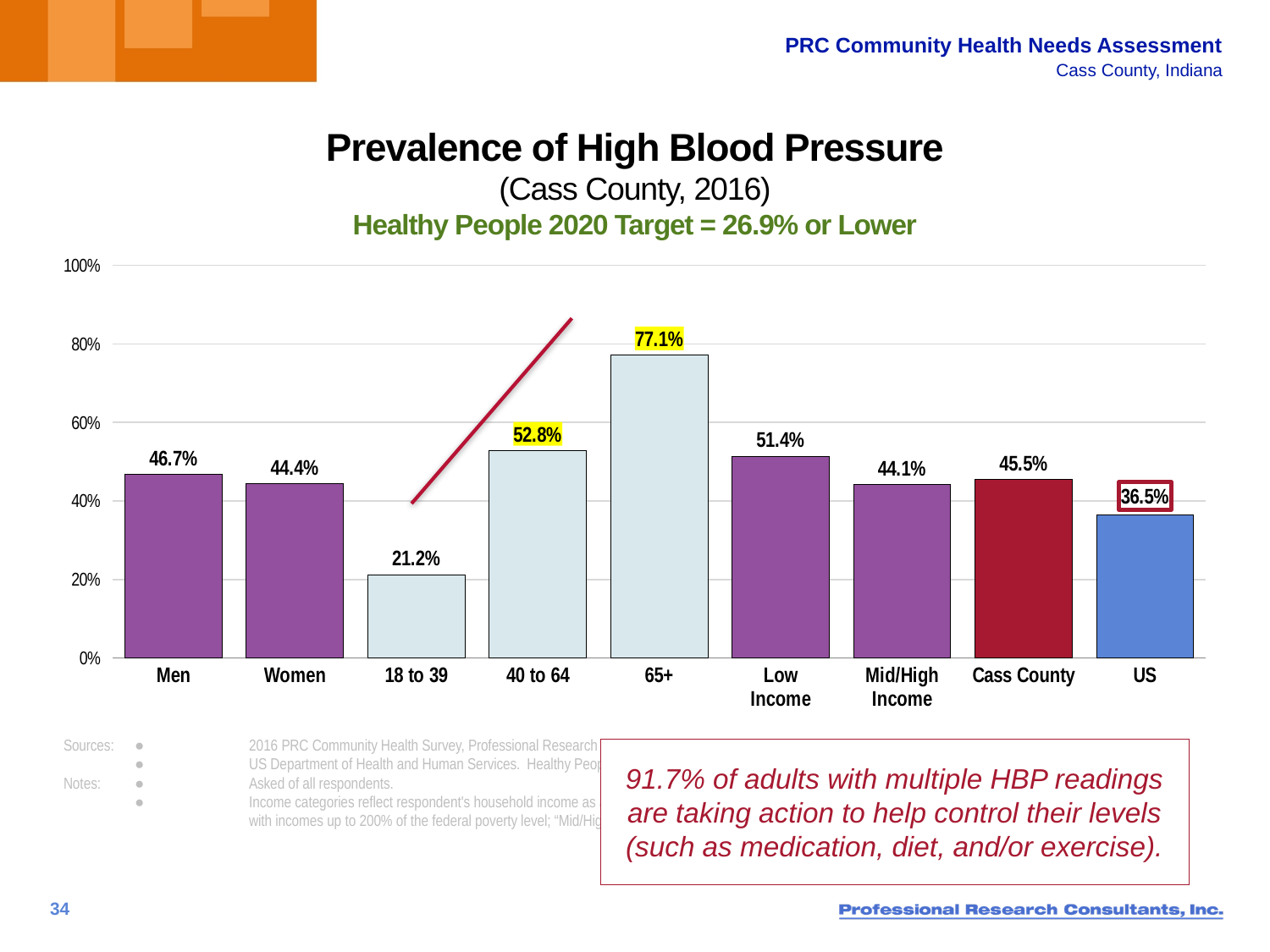
How many categories are shown on the x axis? 9 Which category has the highest prevalence of high blood pressure? 65+ What is the difference between the 65+ value and the 18 to 39 value? 55.9% What is the prevalence of high blood pressure for Men? 46.7% What is the value shown for the US? 36.5% What is the value shown for Low Income? 51.4% What is the difference between the Cass County value and the US value? 9.0% What is the value shown for the 65+ age group? 77.1% What is the Healthy People 2020 Target stated in the chart subtitle? 26.9% or Lower Which is larger, the value for Low Income or the value for Mid/High Income? Low Income Which category has the lowest prevalence of high blood pressure? 18 to 39 What kind of chart is shown on the slide? Bar chart